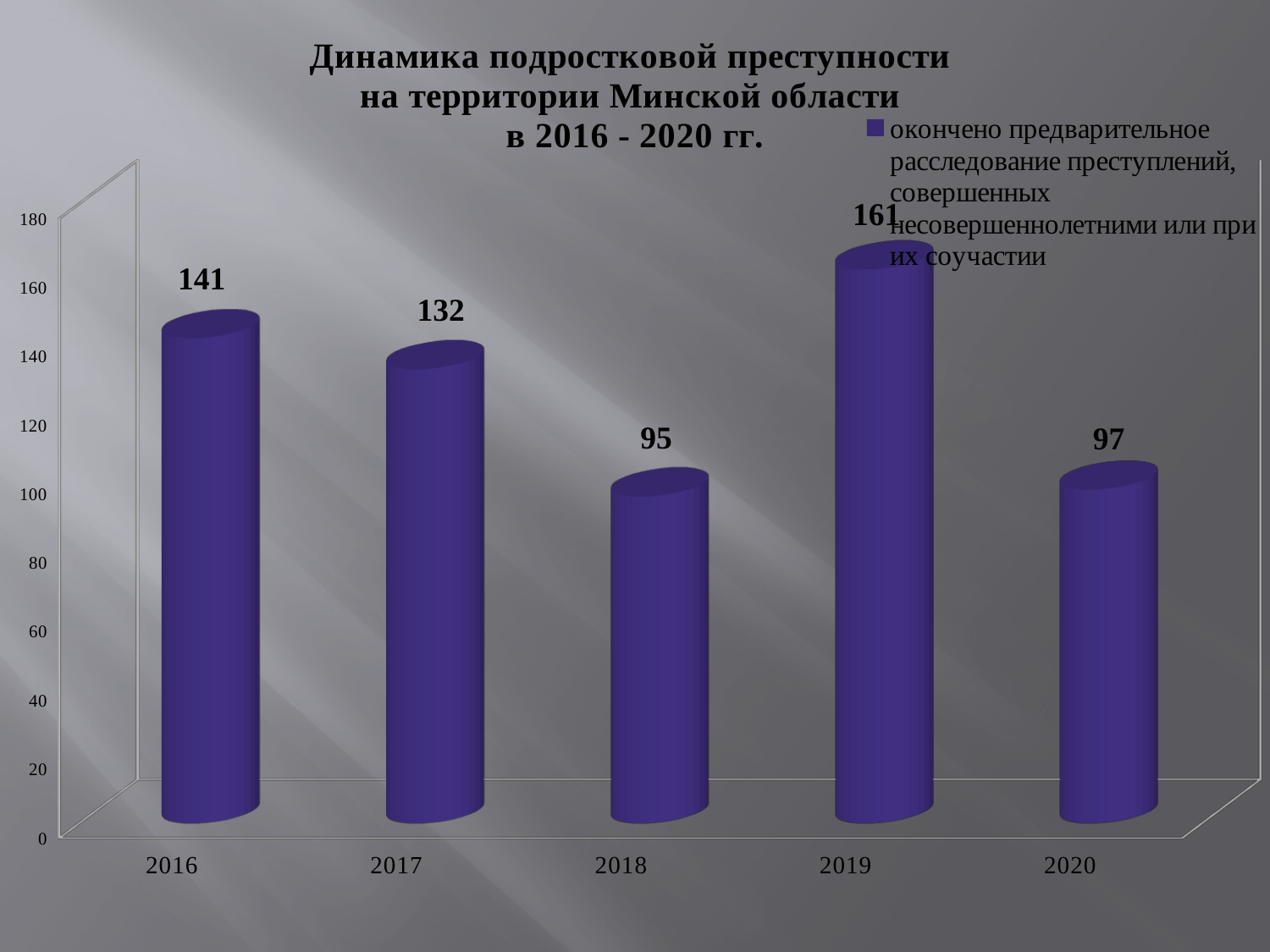
Which year has the lowest value? 2018 What is the difference between the values for 2016 and 2017? 9 What is the value for 2020? 97 Which year has the highest value? 2019 Is the value for 2019 greater or less than 140? greater What is the value for 2018? 95 Which is larger, the value for 2017 or the value for 2020? 2017 How many years are shown on the x axis? 5 What kind of chart is shown on the slide? bar chart What is the difference between the values for 2019 and 2018? 66 How many series does the legend list? 1 What is the value for 2016? 141